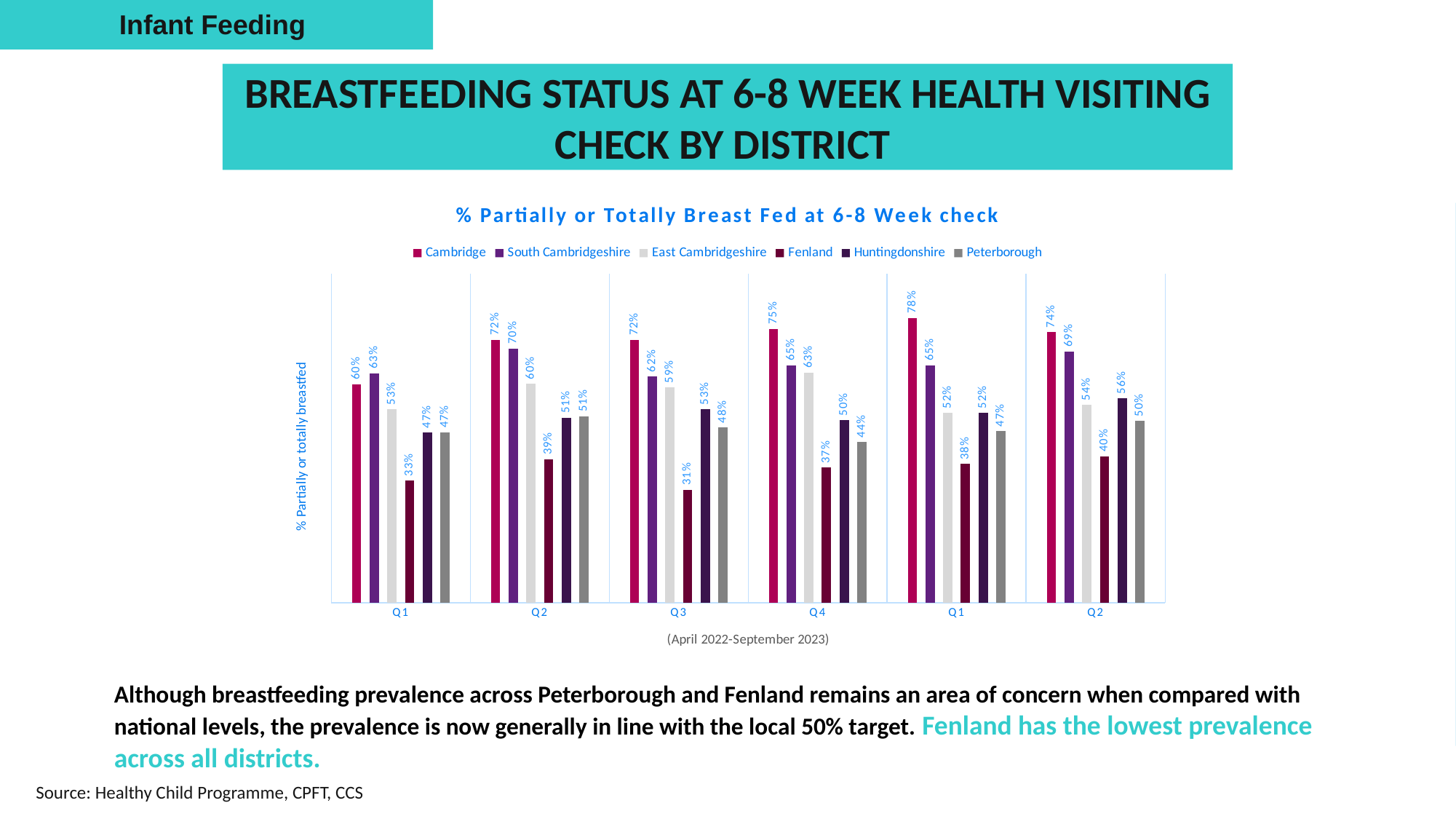
What is the value for East Cambridgeshire in the last Q2 group (rightmost)? 54% What is the value for Cambridge in the Q4 group? 75% How many quarter groups are shown on the x axis? 6 What is the value for Fenland in the Q3 group? 31% How many series does the legend list? 6 What kind of chart is shown on the slide? Bar chart Which district has the highest value in the second Q1 group (fifth group from the left)? Cambridge In the rightmost Q2 group, which is larger: Huntingdonshire or Peterborough? Huntingdonshire Which district has the lowest value in the Q4 group? Fenland What is the difference between the Cambridge and Fenland values in the Q3 group? 41% What is the value for Peterborough in the first Q1 group (leftmost)? 47% What is the title of the chart? % Partially or Totally Breast Fed at 6-8 Week check